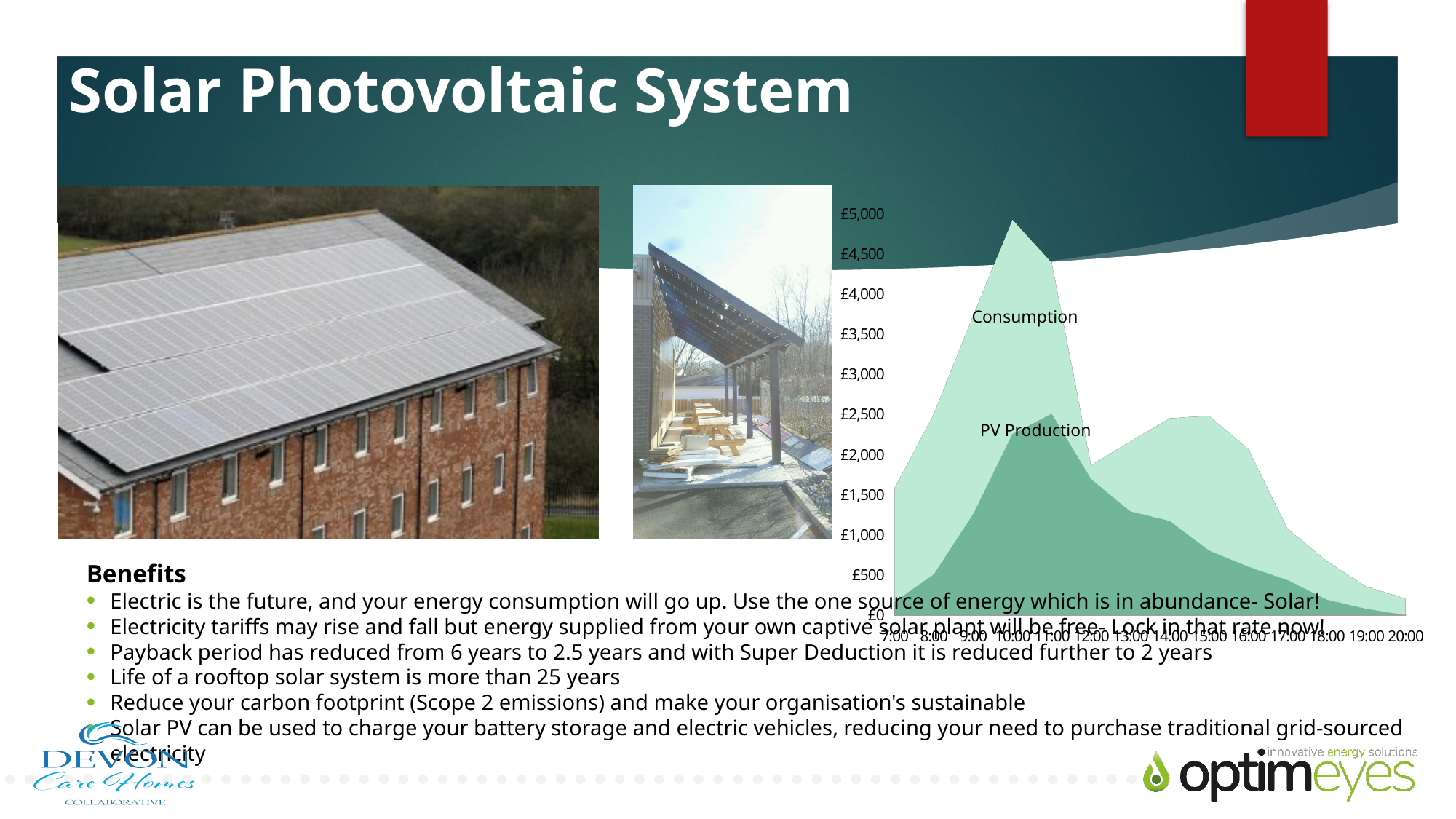
How many series are plotted in the chart? 2 Is the Consumption value at 7:00 greater or less than £1,000? greater Is the peak value of Consumption greater or less than £4,500? greater Which series reaches the higher peak value, Consumption or PV Production? Consumption What are the names of the two series in the chart? Consumption and PV Production How many time points are shown on the x axis of the chart? 14 What is the first time label on the x axis of the chart? 7:00 Is the Consumption value at 20:00 greater or less than £500? less Do the Consumption values rise or fall between 17:00 and 20:00? fall What kind of chart is shown on the slide? Area chart